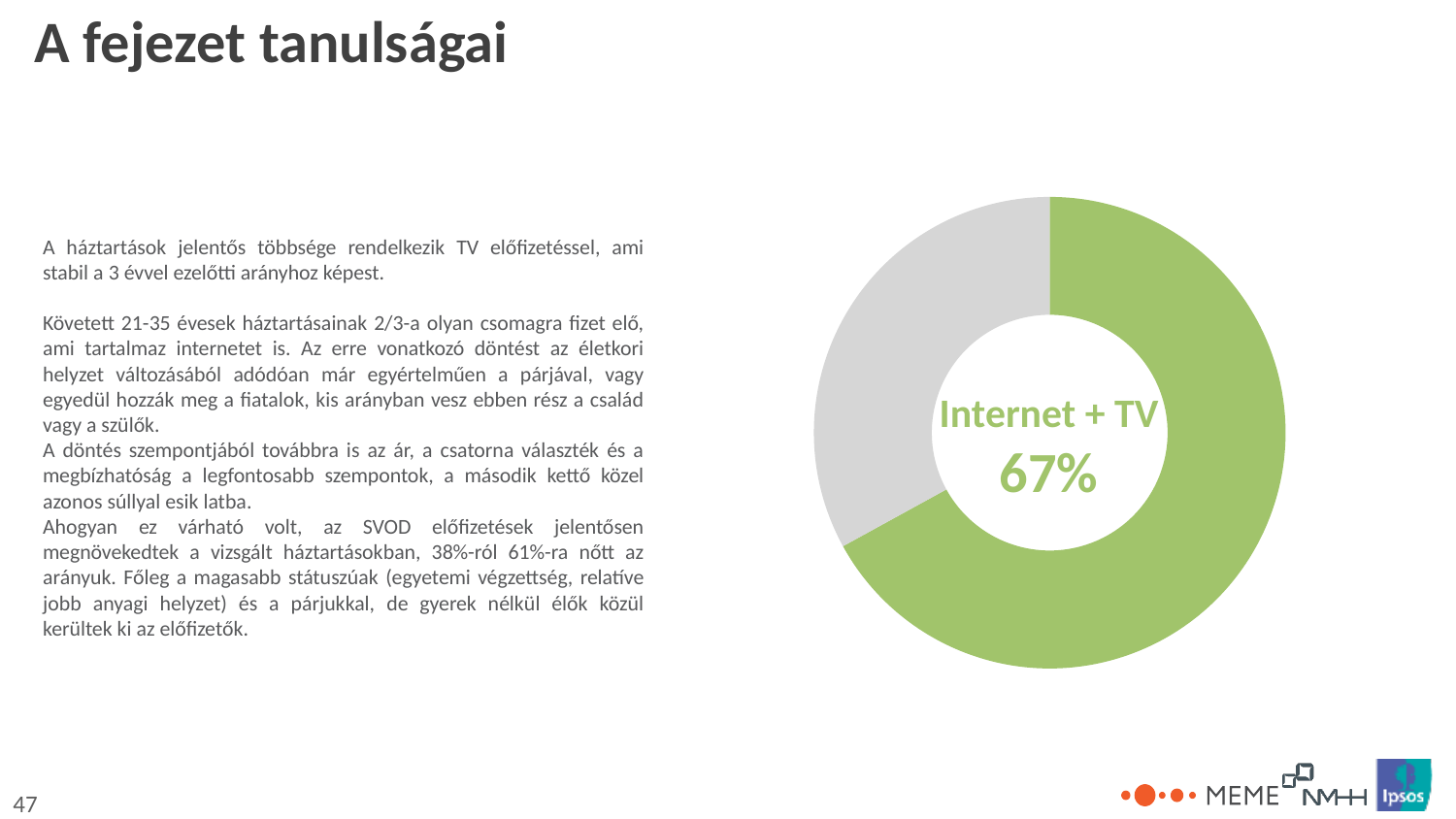
What label is printed in the centre of the doughnut chart? Internet + TV 67% What percentage is shown for Internet + TV in the chart? 67% How many slices does the chart have? 2 Is the value for Internet + TV greater or less than 50%? greater What colour is the Internet + TV slice in the chart? green Which slice of the chart is larger, the green one or the grey one? the green one What share of the pie does the Internet + TV slice represent? 67% What kind of chart is shown on the right side of the slide? doughnut (pie) chart